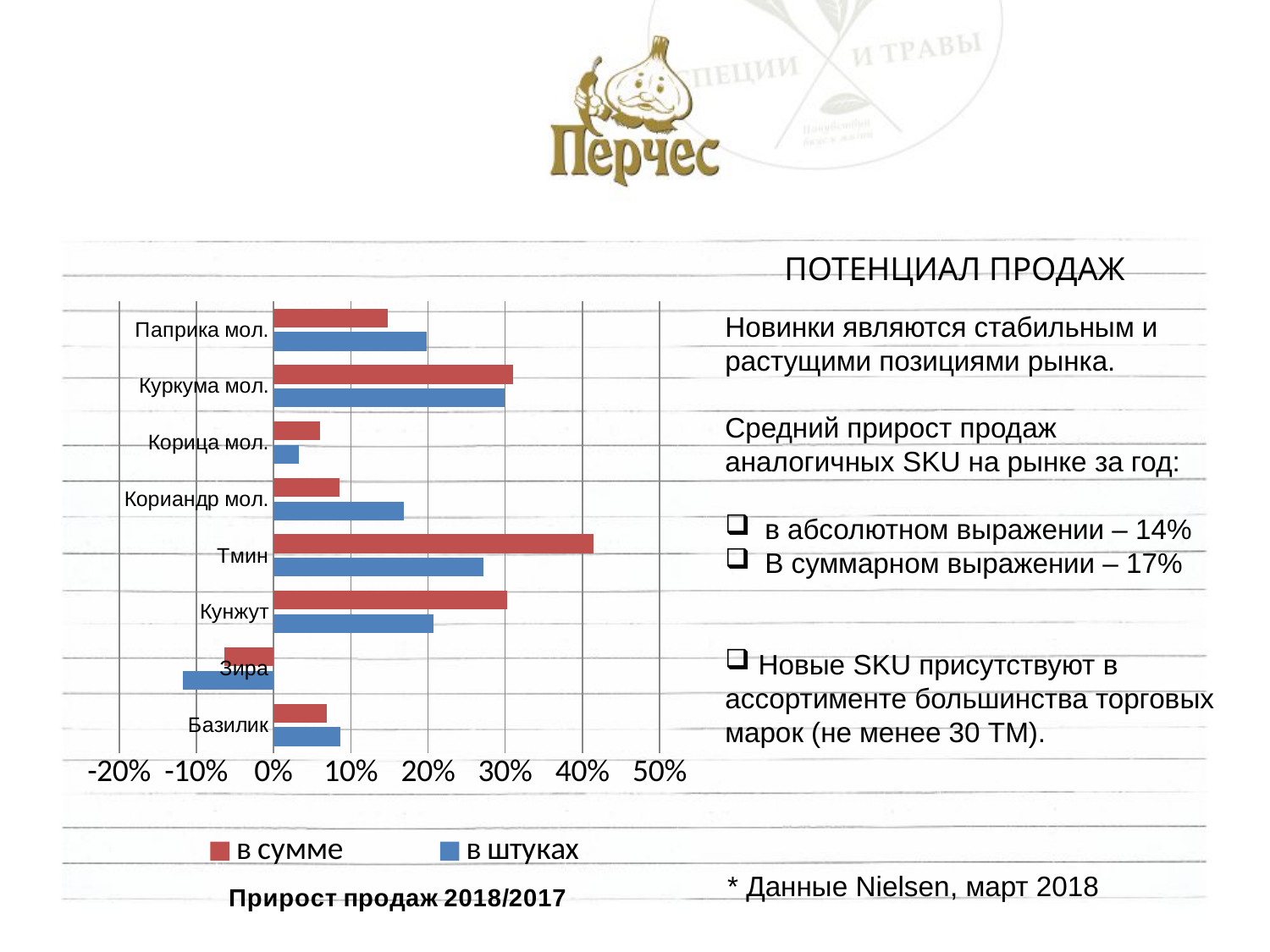
What is the title of the chart? Прирост продаж 2018/2017 Which category has the lowest value for the series "в штуках"? Зира Is the value for Корица мол. in the series "в штуках" greater or less than 10%? less Is the value for Зира in the series "в штуках" greater or less than -10%? less What kind of chart is shown on the slide? bar chart For Кориандр мол., which series has the larger value: "в сумме" or "в штуках"? в штуках Which category has the lowest value for the series "в сумме"? Зира How many series does the chart legend list? 2 Which category has the highest value for the series "в сумме"? Тмин How many categories (spices) are shown on the chart? 8 For Кунжут, which series has the larger value: "в сумме" or "в штуках"? в сумме Is the value for Тмин in the series "в сумме" greater or less than 40%? greater